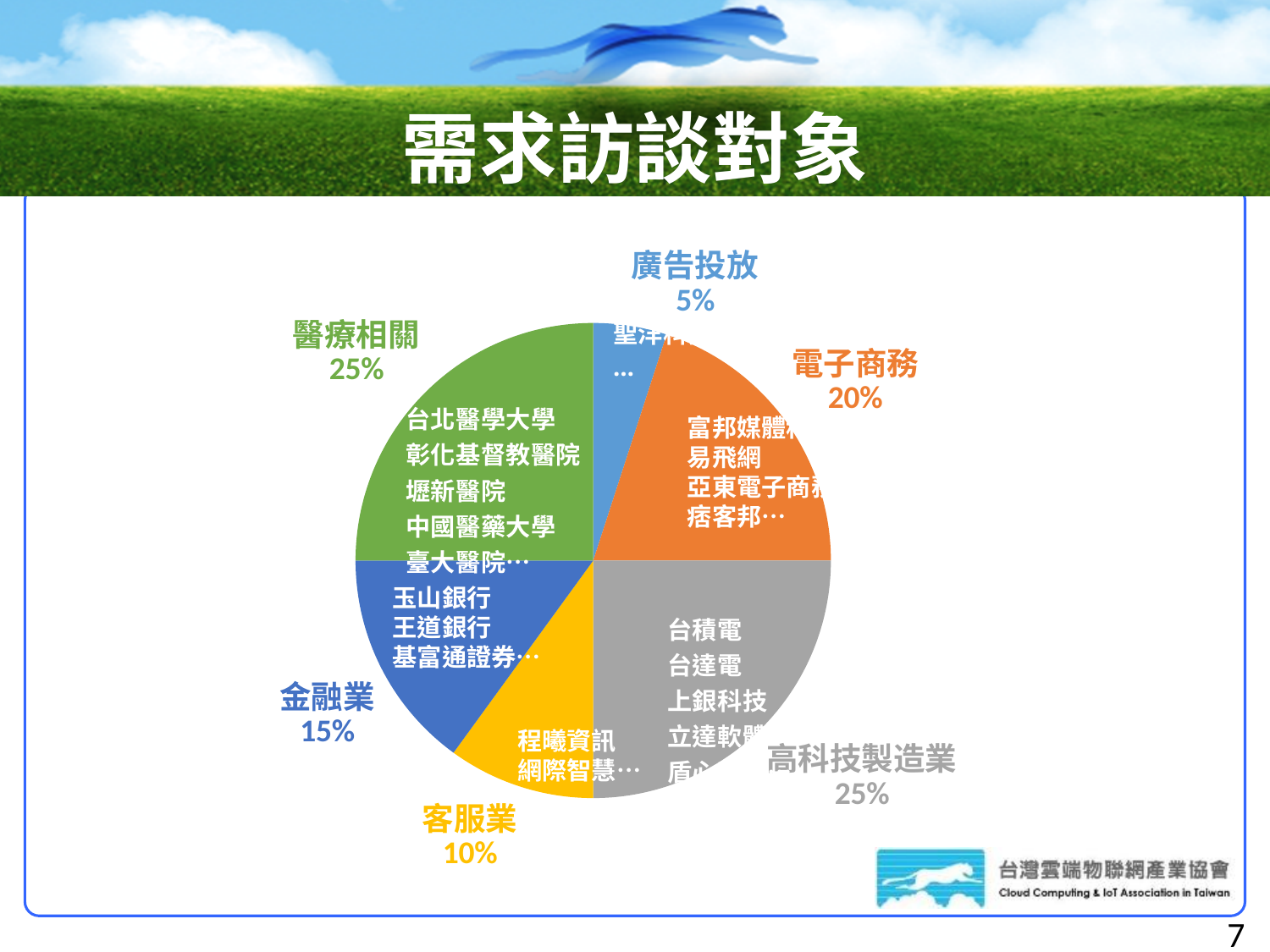
Which two categories share the largest slice of the pie? 醫療相關 and 高科技製造業 Which is larger, the share of 客服業 or the share of 金融業? 金融業 What is the title of the slide containing the pie chart? 需求訪談對象 What is the difference between the shares of 電子商務 and 金融業? 5% What share of the pie does 高科技製造業 have? 25% What share of the pie does 廣告投放 have? 5% Which category has the smallest slice of the pie? 廣告投放 How many categories are shown in the pie chart? 6 What share of the pie does 電子商務 have? 20% What kind of chart is shown on the slide? pie chart What share of the pie does 客服業 have? 10% What share of the pie does 金融業 have? 15%